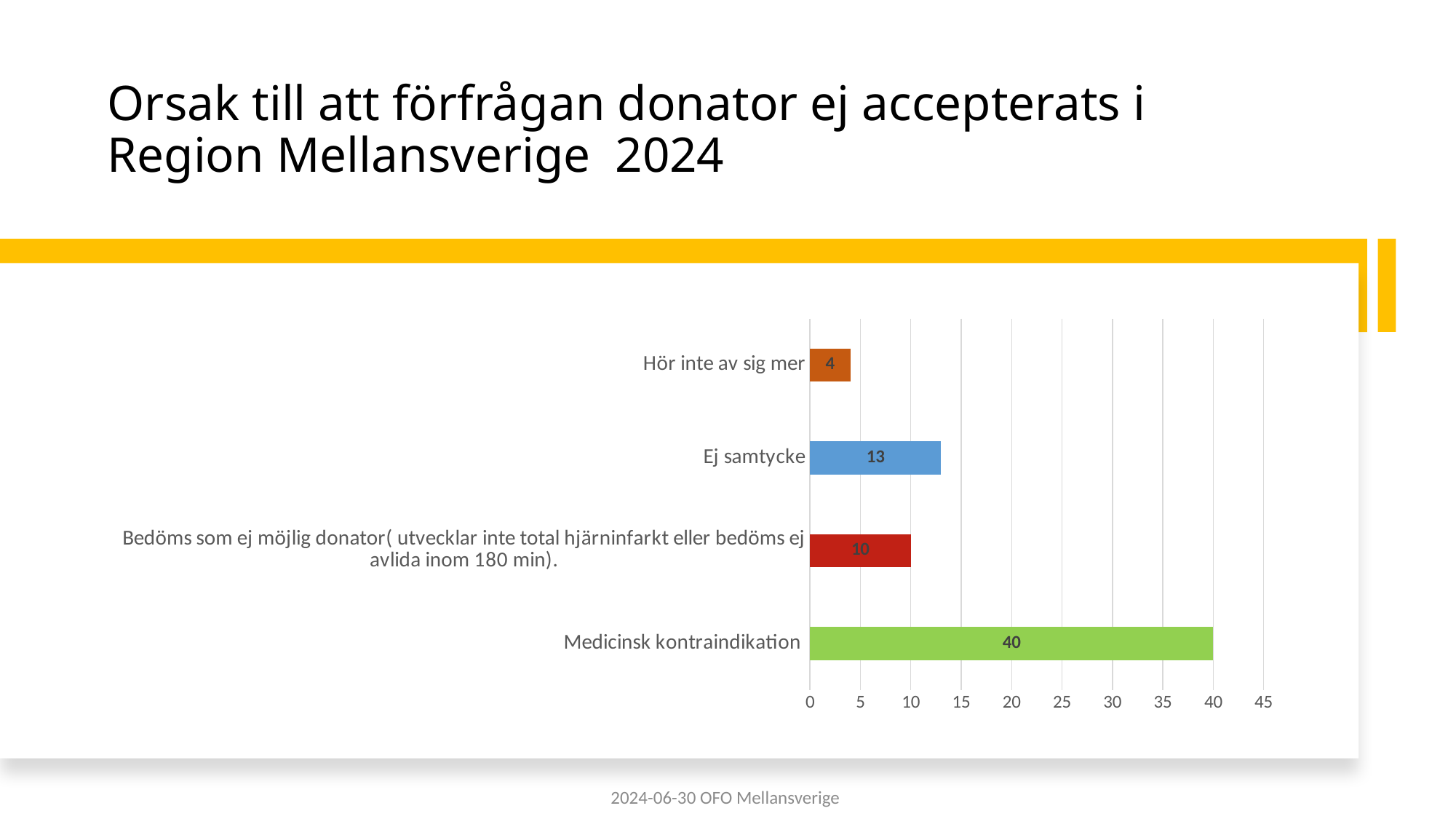
What is the difference between the values for Medicinsk kontraindikation and Ej samtycke? 27 Which category has the highest value? Medicinsk kontraindikation Which is larger, the value for Ej samtycke or the value for Bedöms som ej möjlig donator? Ej samtycke What is the value for the category 'Bedöms som ej möjlig donator'? 10 What is the value for Hör inte av sig mer? 4 Which category has the lowest value? Hör inte av sig mer What is the value for Ej samtycke? 13 How many categories are shown in the chart? 4 What colour is the bar for Medicinsk kontraindikation? Green What is the value for Medicinsk kontraindikation? 40 What is the difference between the values for Ej samtycke and Hör inte av sig mer? 9 What kind of chart is shown on the slide? Bar chart